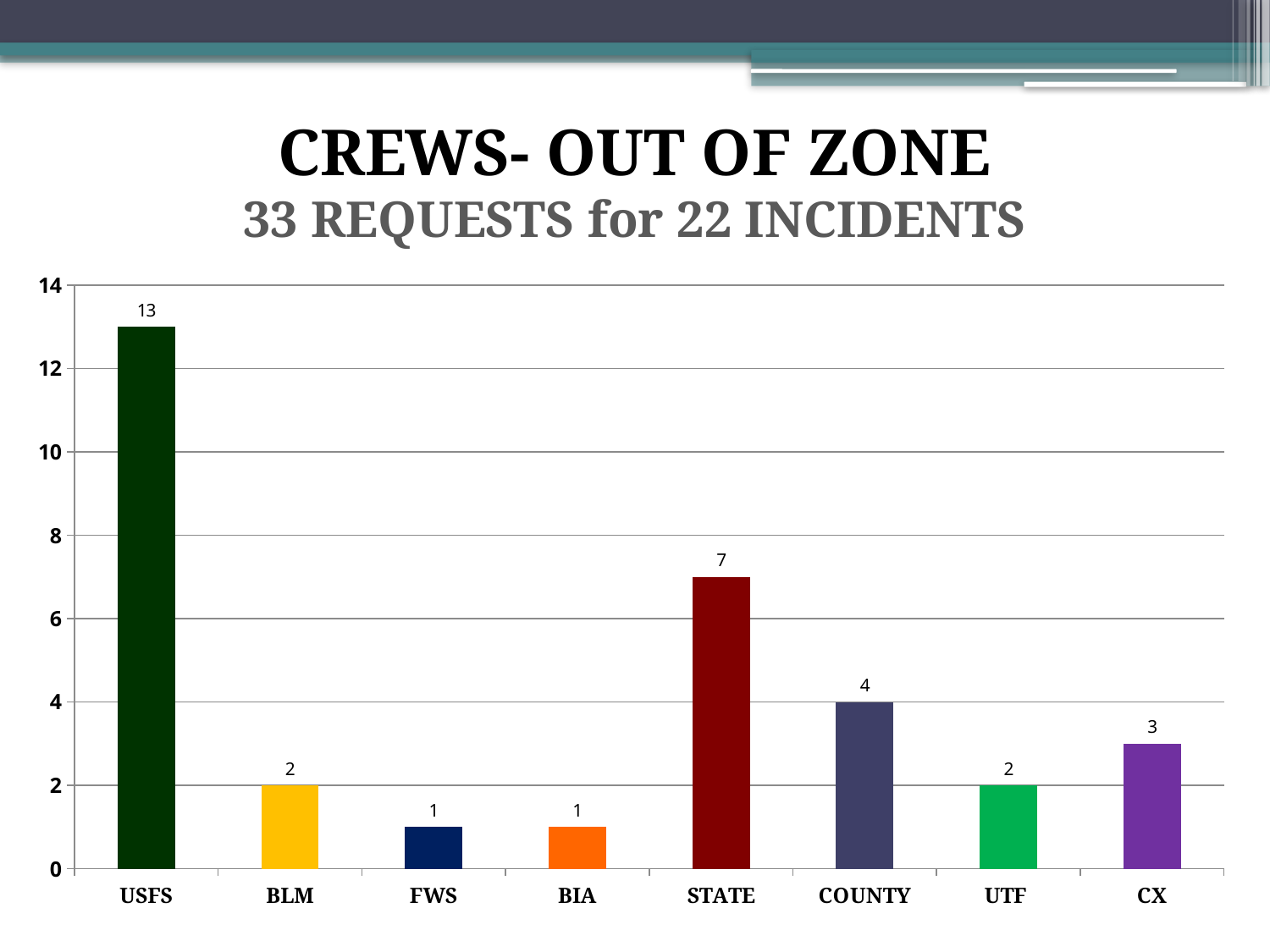
What is the title of the chart? CREWS- OUT OF ZONE What kind of chart is shown on the slide? bar chart What is the value for STATE? 7 What is the difference between the values for USFS and STATE? 6 Which category has the highest value? USFS Is the value for STATE greater or less than 6? greater How many categories are shown on the x axis? 8 What is the value for COUNTY? 4 What is the value for USFS? 13 What is the difference between the values for BLM and FWS? 1 What is the value for CX? 3 Which is larger, the value for COUNTY or the value for CX? COUNTY